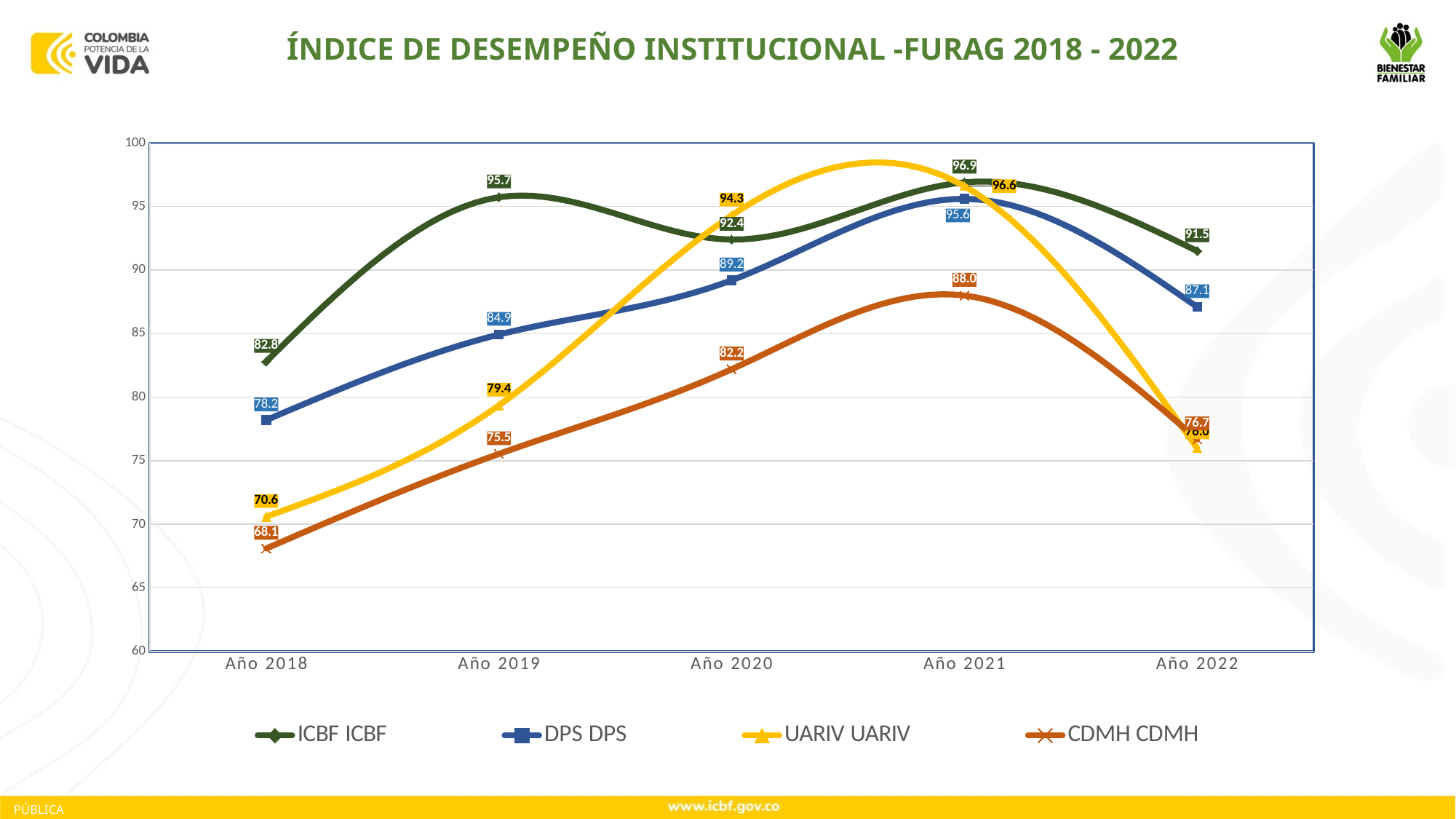
What is the CDMH value for Año 2018? 68.1 What is the DPS value for Año 2021? 95.6 In which year does the ICBF series reach its highest value? Año 2021 What is the ICBF value for Año 2019? 95.7 What is the difference between the ICBF and DPS values in Año 2018? 4.6 How many years are shown on the x axis? 5 What kind of chart is shown on the slide? Line chart What is the UARIV value for Año 2020? 94.3 Which series has the higher value in Año 2020, ICBF or UARIV? UARIV How many series does the legend list? 4 In which year does the CDMH series have its lowest value? Año 2018 Does the DPS series rise or fall from Año 2018 to Año 2021? Rise